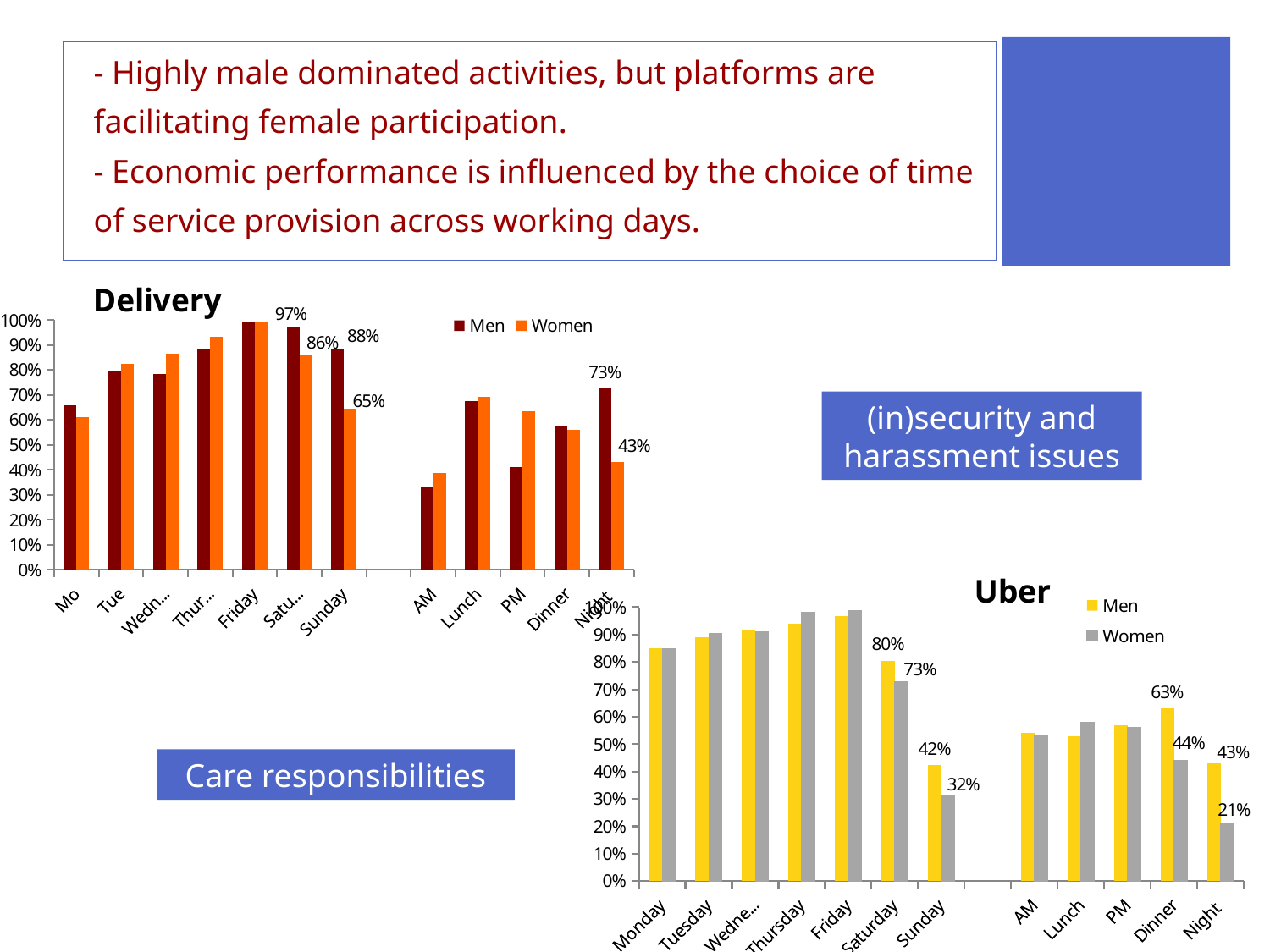
In the Uber chart, which is larger on Sunday, the Men value or the Women value? Men How many categories are shown on the x axis of the Uber chart? 12 In the Delivery chart, what is the difference between the Men and Women values at Night? 30 percentage points In the Delivery chart, what is the value for Women on Sunday? 65% In the Uber chart, what is the difference between the Men and Women values on Saturday? 7 percentage points How many series does the legend of the Uber chart list? 2 In the Delivery chart, is the value for Women on Friday greater or less than 90%? greater In the Delivery chart, what is the value for Men on Saturday? 97% In the Uber chart, what is the value for Women at Night? 21% What kind of chart is the Delivery chart? bar chart In the Delivery chart, is the value for Men at AM greater or less than 40%? less In the Uber chart, what is the value for Men at Dinner? 63%